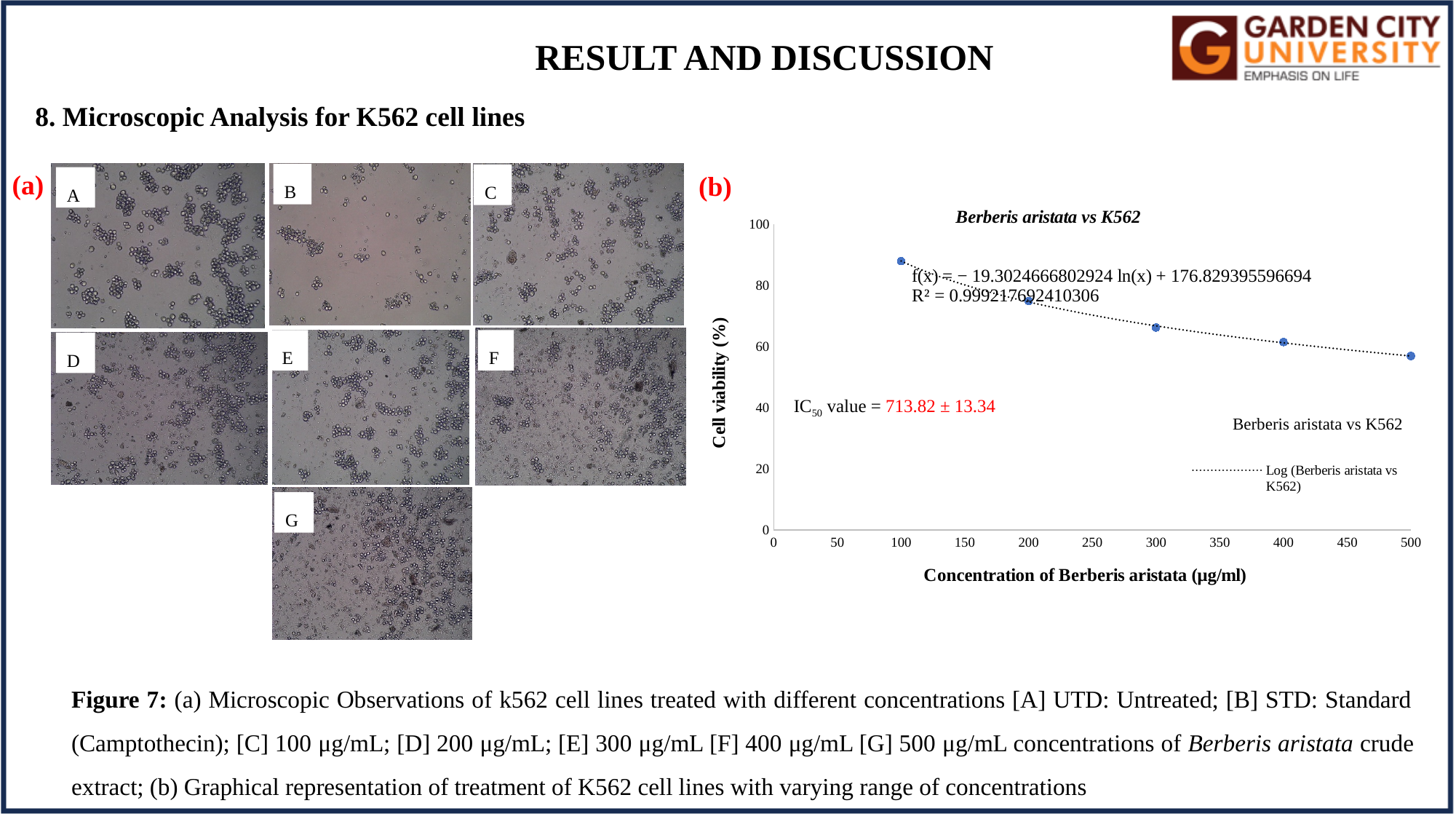
Is the cell viability at a concentration of 200 greater or less than 80? less At which concentration is cell viability lowest? 500 At which concentration is cell viability highest? 100 Which has higher cell viability, the concentration of 100 or the concentration of 500? 100 How many data points are plotted in the chart? 5 Is the cell viability at a concentration of 100 greater or less than 80? greater What is the title of the chart? Berberis aristata vs K562 Does cell viability rise or fall as the concentration of Berberis aristata increases? fall How many entries does the chart legend list? 2 Is the cell viability at a concentration of 300 greater or less than 60? greater What IC50 value is printed on the chart? 713.82 ± 13.34 What kind of chart is shown in panel (b)? scatter chart